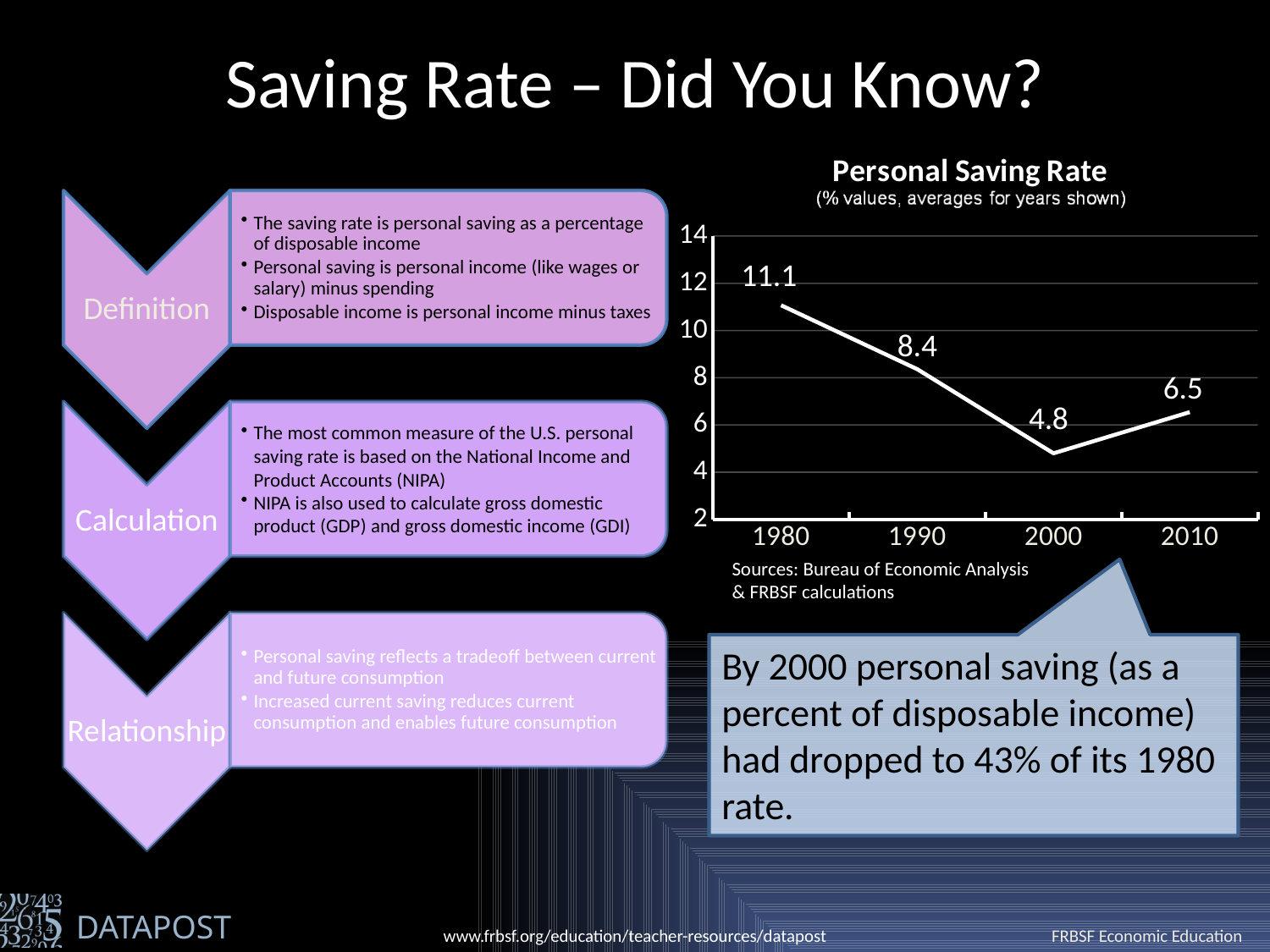
What is the personal saving rate shown for 2000? 4.8 What is the personal saving rate shown for 1980? 11.1 Which year has the lowest personal saving rate on the chart? 2000 What is the difference between the personal saving rate in 2010 and in 2000? 1.7 How many years are plotted on the Personal Saving Rate chart? 4 Does the personal saving rate rise or fall from 1980 to 2000? fall What is the difference between the personal saving rate in 1980 and in 1990? 2.7 Is the personal saving rate for 1990 greater or less than 8? greater What is the personal saving rate shown for 2010? 6.5 What kind of chart is the Personal Saving Rate chart? line chart Which year has a higher personal saving rate, 1990 or 2010? 1990 Which year has the highest personal saving rate on the chart? 1980